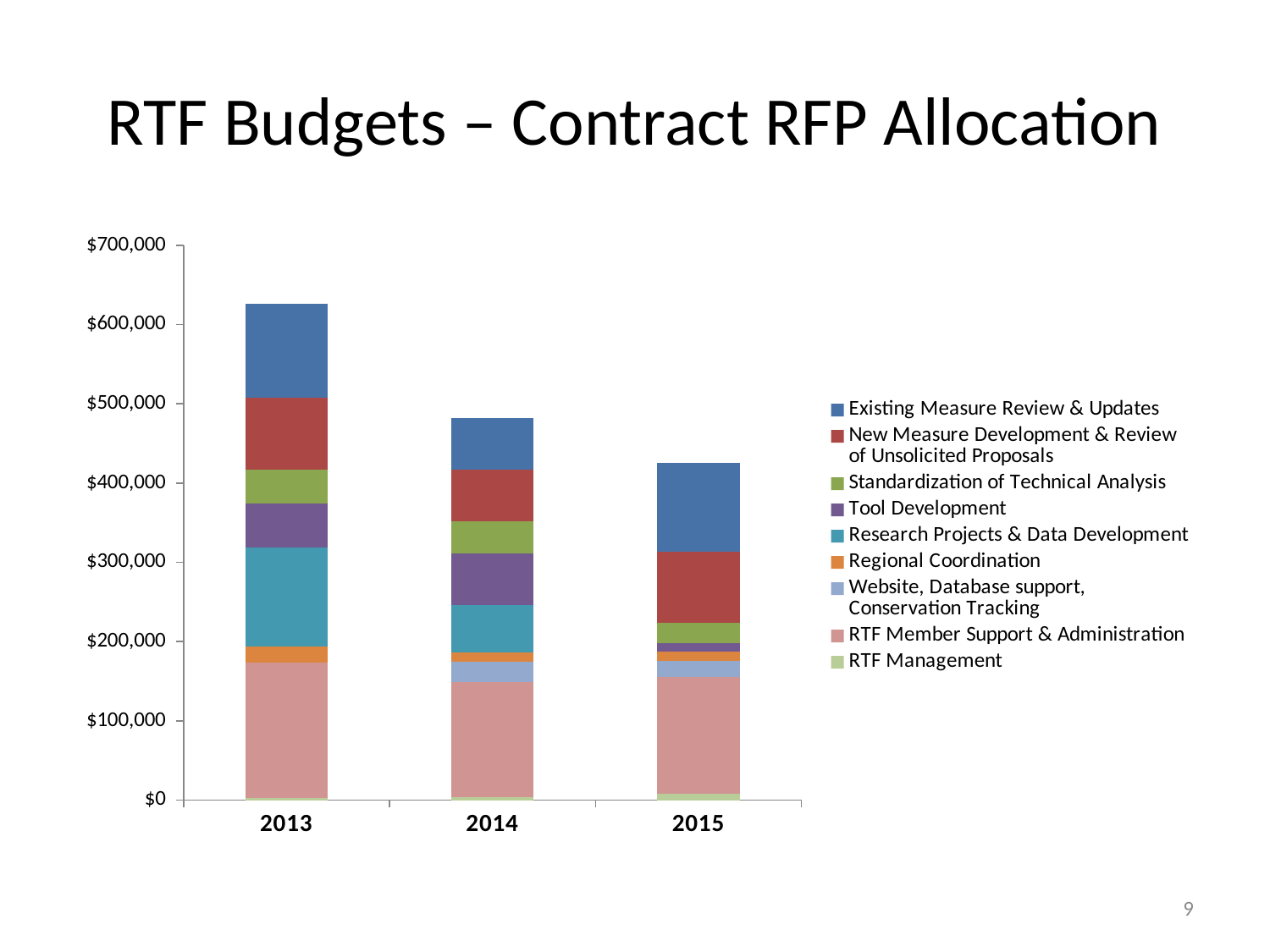
How many years (categories) are shown on the x axis of the chart? 3 What is the title of the slide containing the chart? RTF Budgets – Contract RFP Allocation Which is larger, the total bar for 2014 or the total bar for 2015? 2014 Which year has the lowest total bar in the chart? 2015 Which series is listed first in the chart's legend? Existing Measure Review & Updates Is the total bar for 2013 greater or less than $600,000? greater Is the total bar for 2014 greater or less than $500,000? less Do the total bar heights rise or fall from 2013 to 2015? fall Is the total bar for 2015 greater or less than $400,000? greater How many series does the chart's legend list? 9 What kind of chart is shown on the slide? stacked bar chart Which year has the highest total bar in the chart? 2013